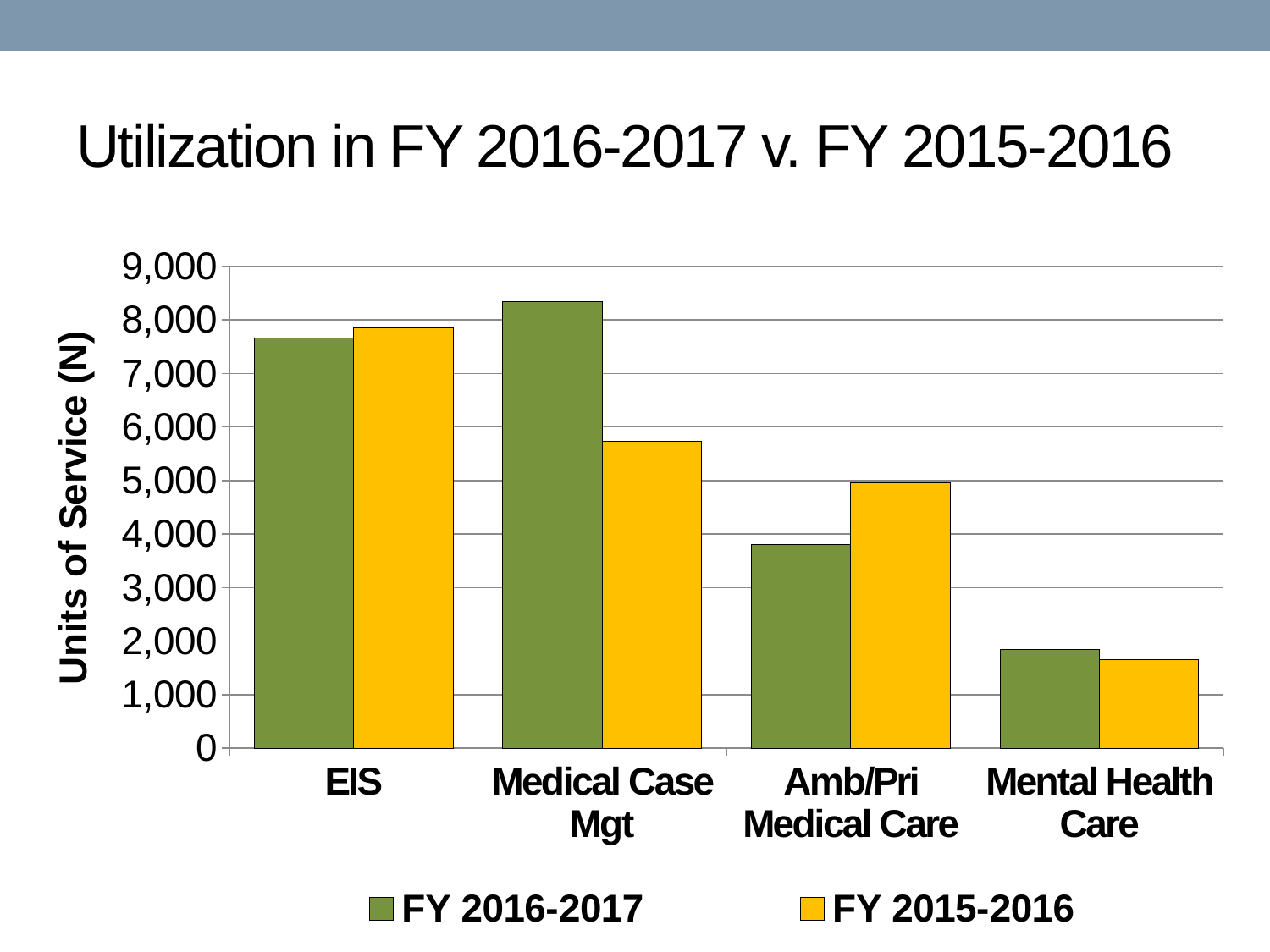
For Medical Case Mgt, which series has the larger value, FY 2016-2017 or FY 2015-2016? FY 2016-2017 Which category has the highest value for FY 2015-2016? EIS How many categories are shown on the x axis? 4 Which category has the lowest value for FY 2016-2017? Mental Health Care Is the FY 2016-2017 value for Medical Case Mgt greater or less than 8,000? greater Which category has the highest value for FY 2016-2017? Medical Case Mgt What kind of chart is shown on the slide? bar chart Is the FY 2016-2017 value for Mental Health Care greater or less than 2,000? less How many series does the legend list? 2 For Amb/Pri Medical Care, which series has the larger value, FY 2016-2017 or FY 2015-2016? FY 2015-2016 What is the label of the y axis? Units of Service (N) Which category has the lowest value for FY 2015-2016? Mental Health Care